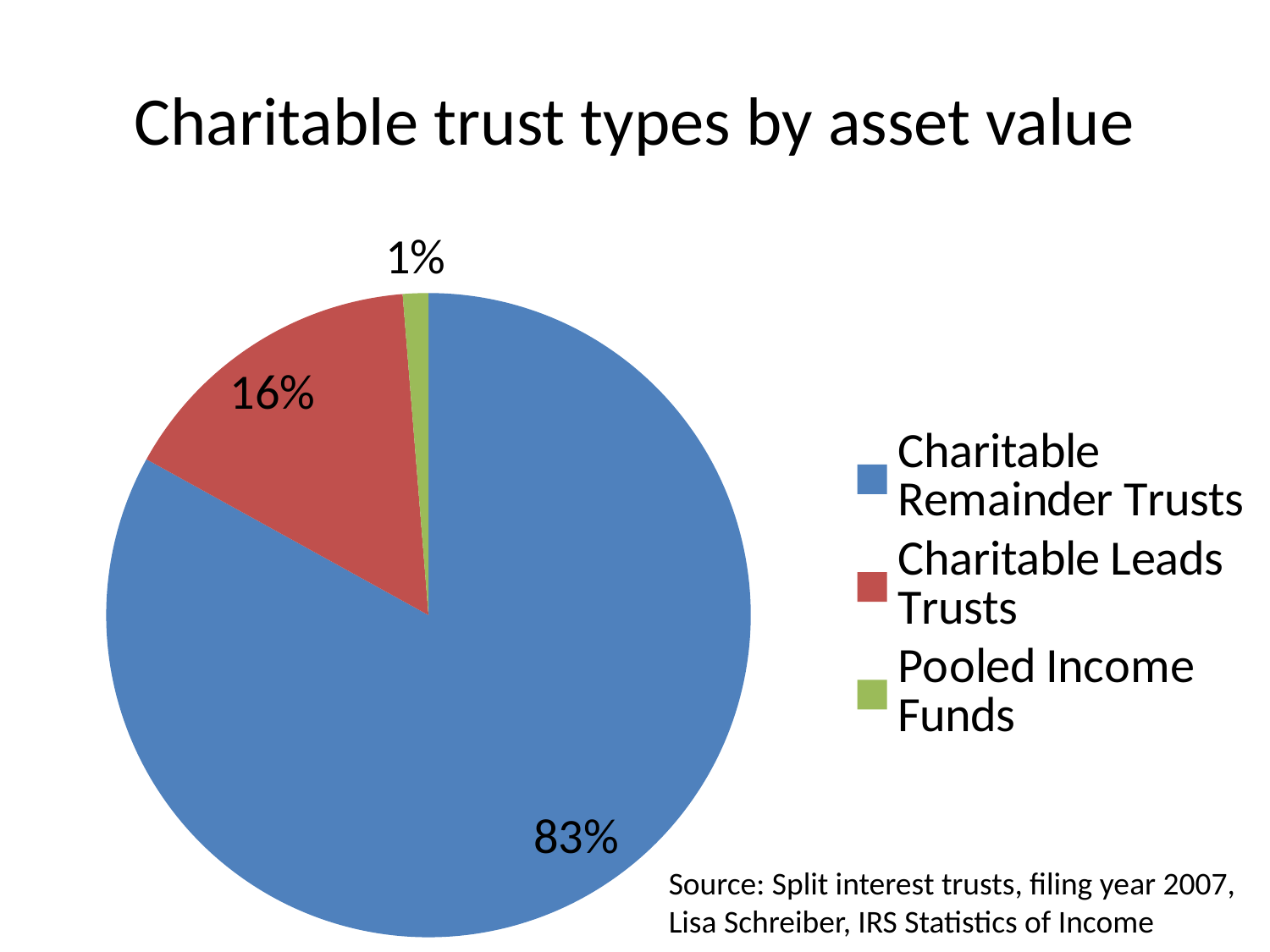
Which trust type has the largest share of asset value? Charitable Remainder Trusts What is the difference in percentage points between Charitable Leads Trusts and Pooled Income Funds? 15 Which has a larger share, Charitable Leads Trusts or Pooled Income Funds? Charitable Leads Trusts What is the title of the chart? Charitable trust types by asset value Which trust type has the smallest share of asset value? Pooled Income Funds How many slices does the pie chart have? 3 What share of the pie do Pooled Income Funds represent? 1% What share of the pie do Charitable Remainder Trusts represent? 83% What colour is the slice for Charitable Leads Trusts? Red What is the difference in percentage points between Charitable Remainder Trusts and Charitable Leads Trusts? 67 What share of the pie do Charitable Leads Trusts represent? 16% What kind of chart is shown on the slide? Pie chart